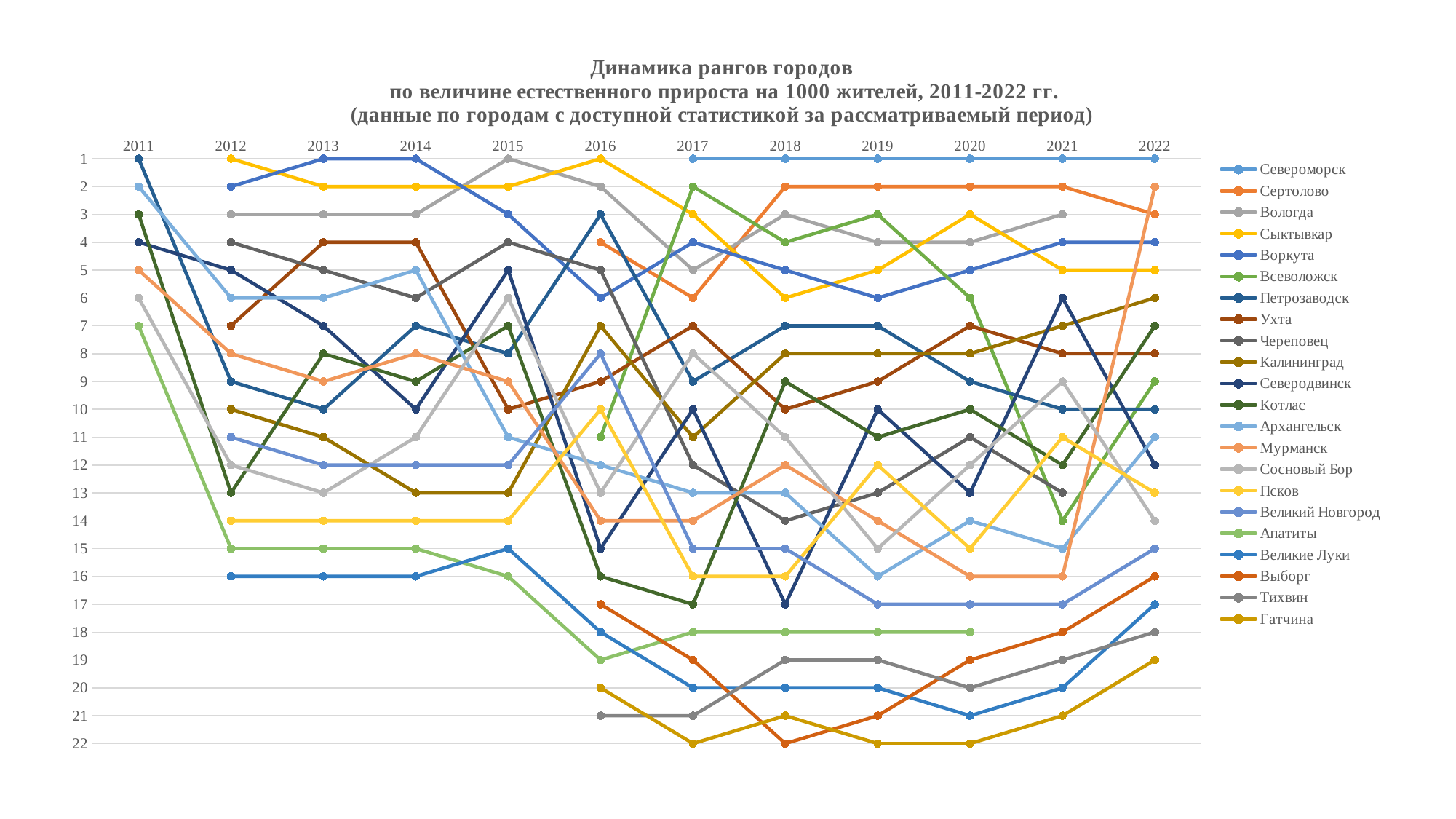
How many cities are listed in the legend? 22 What kind of chart is shown on the slide? Line chart By how many positions does the rank number of Великие Луки differ between 2020 and 2022? 4 What rank does Великие Луки hold in 2020? 21 What rank does Сыктывкар hold in 2012? 1 What rank does Выборг hold in 2018? 22 What rank does Гатчина hold in 2017? 22 How many years are shown on the x axis? 12 Which city is listed first in the legend? Североморск What rank does Североморск hold in 2022? 1 What rank does Сертолово hold in 2019? 2 What rank does Апатиты hold in 2018? 18